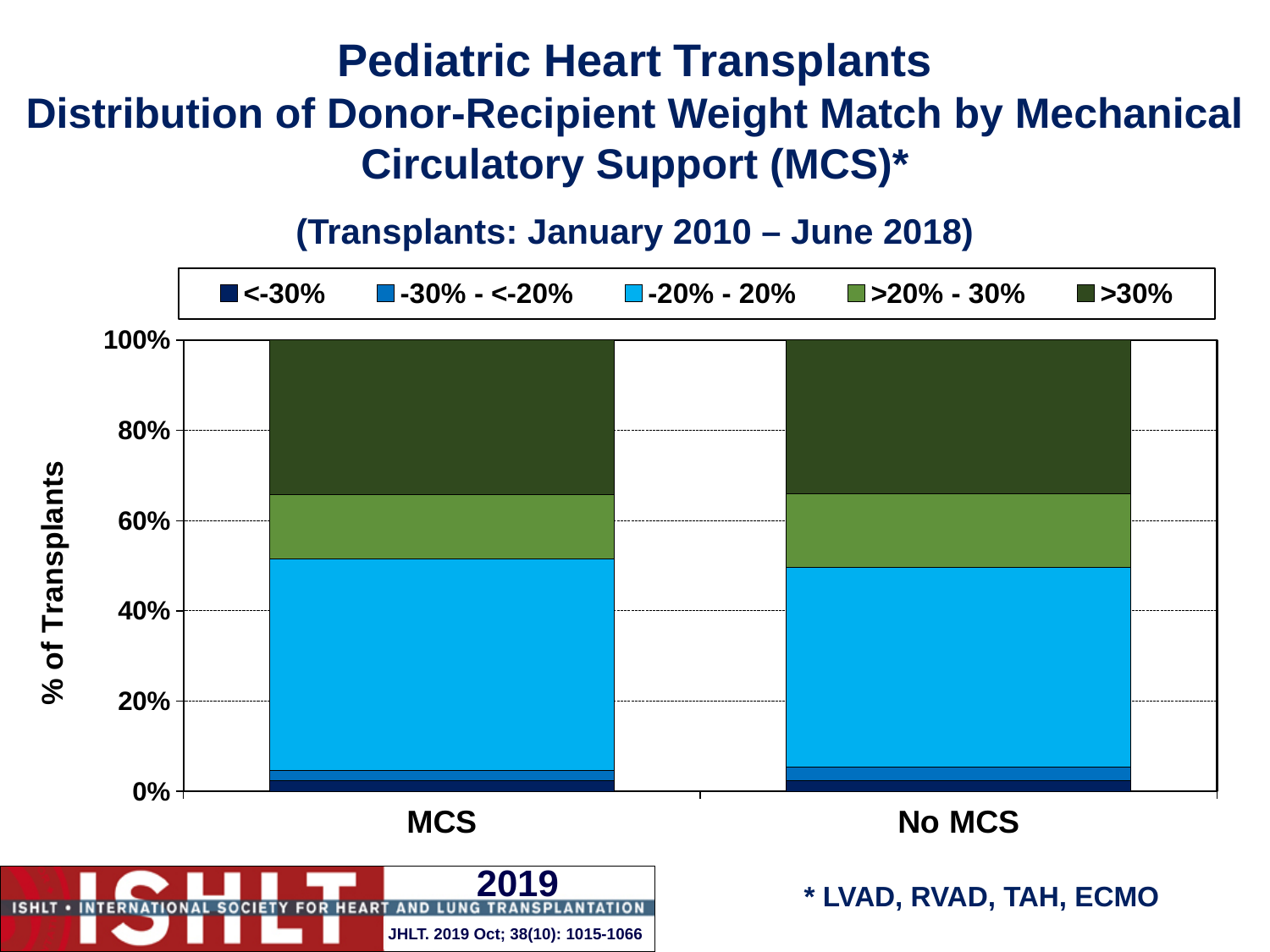
Which segment is the largest in the MCS bar? -20% - 20% What kind of chart is shown on the slide? Stacked bar chart What is the label of the y axis? % of Transplants How many categories are shown on the x axis of the chart? 2 Is the value of the >30% segment for MCS greater or less than 20%? greater Is the value of the -30% - <-20% segment for MCS greater or less than 20%? less What are the two categories shown on the x axis? MCS and No MCS Is the value of the -20% - 20% segment for MCS greater or less than 40%? greater How many series does the legend list? 5